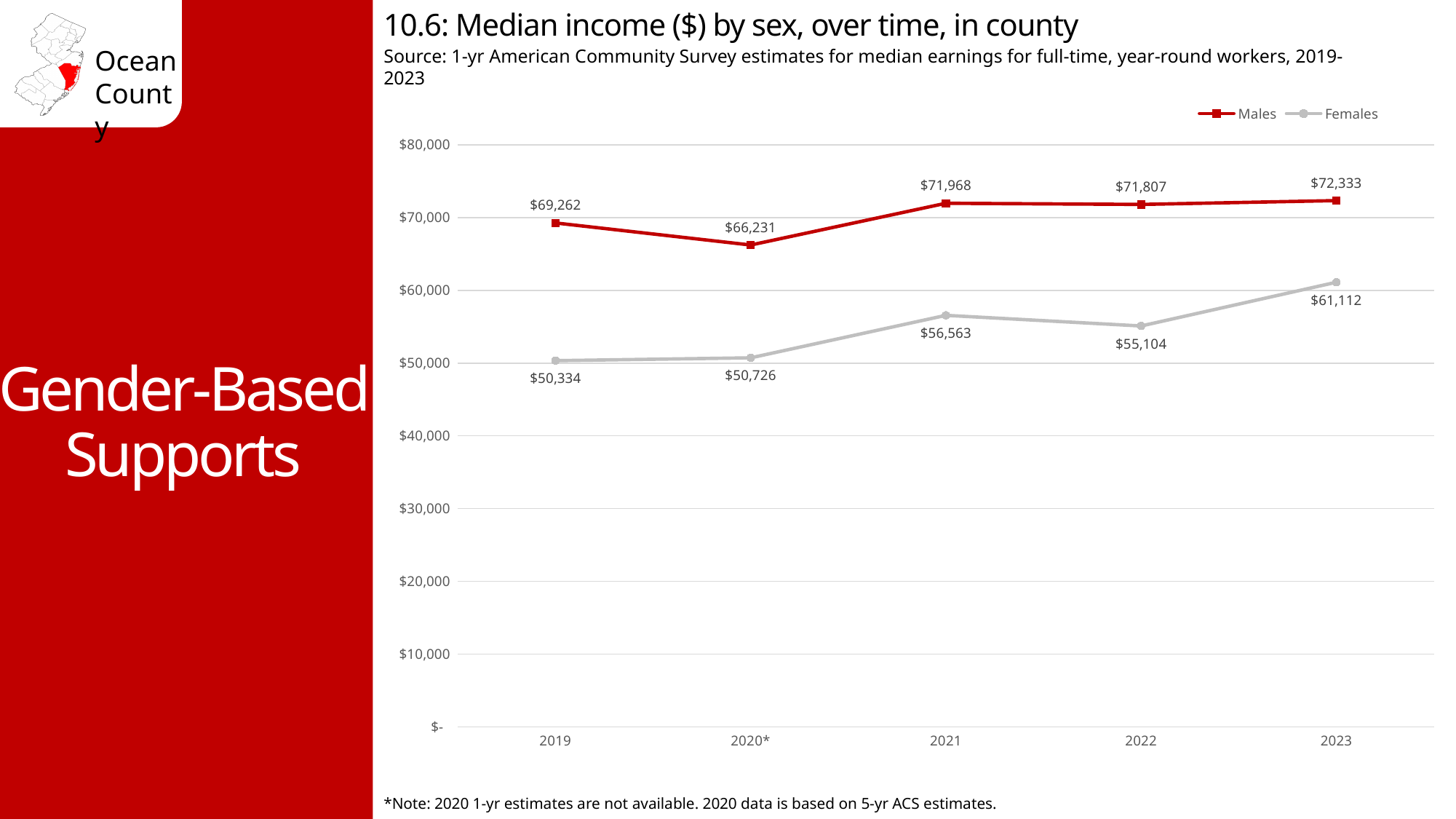
How many years are shown on the x axis? 5 Which was larger in 2019: the median income for Males or for Females? Males What kind of chart is shown on the slide? Line chart In which year was the median income for Males the highest? 2023 How many series does the legend list? 2 What was the median income for Males in 2021? $71,968 In which year was the median income for Males the lowest? 2020* In which year was the median income for Females the lowest? 2019 What was the median income for Females in 2020*? $50,726 What is the difference between the Males and Females median income in 2023? $11,221 What was the median income for Females in 2022? $55,104 How much did the Females median income increase from 2022 to 2023? $6,008